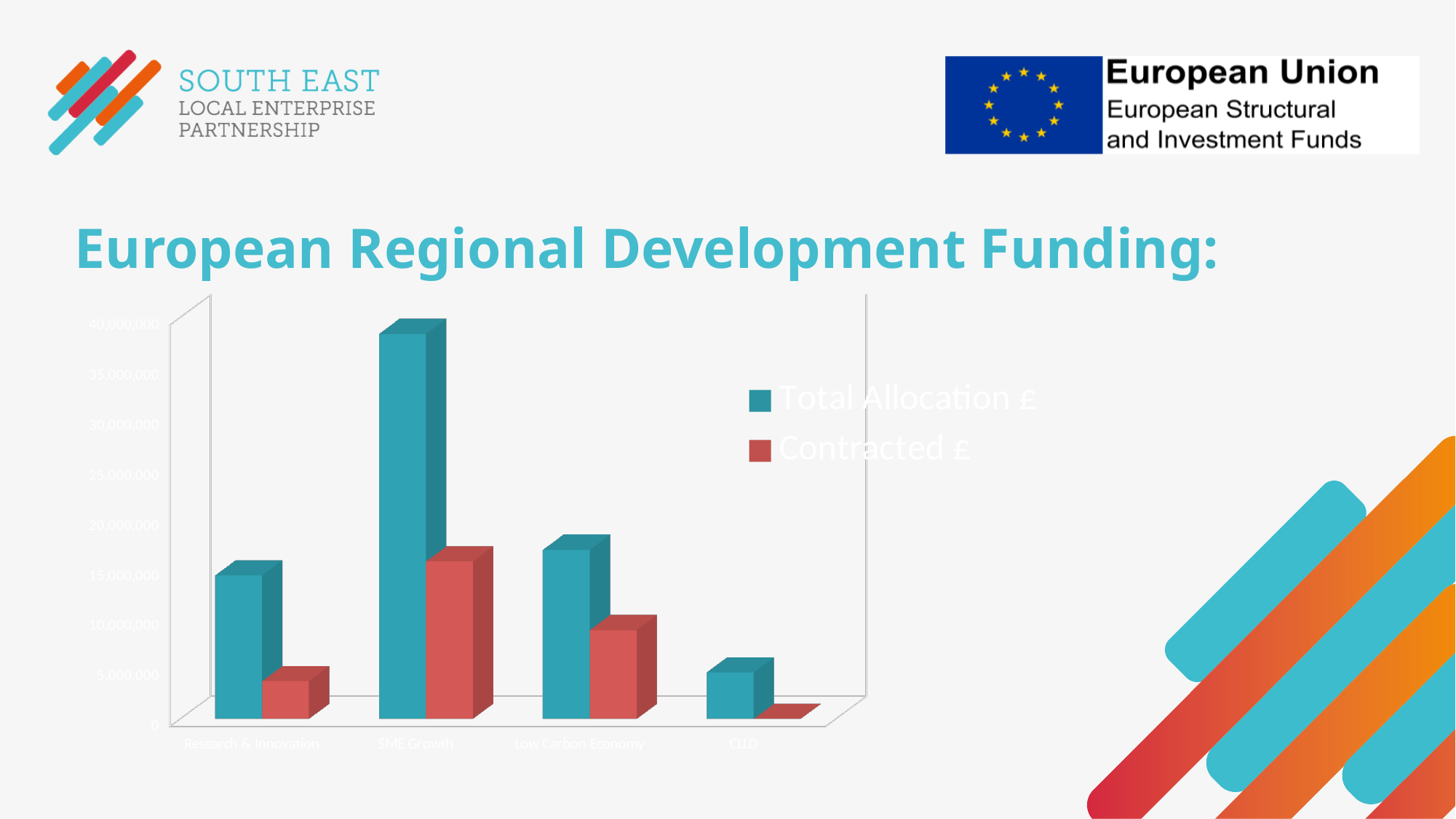
Is the Contracted £ for Research & Innovation greater or less than 5,000,000? less Which category has the lowest Total Allocation £? CLLD How many categories are shown on the x axis of the chart? 4 How many series does the chart's legend list? 2 Is the Total Allocation £ for CLLD greater or less than 10,000,000? less Is the Contracted £ for SME Growth greater or less than 10,000,000? greater Which is larger: the Total Allocation £ for Low Carbon Economy or for Research & Innovation? Low Carbon Economy Which category has the highest Total Allocation £? SME Growth What are the two series named in the chart's legend? Total Allocation £ and Contracted £ Which category has the lowest Contracted £? CLLD What kind of chart is shown on the slide? bar chart